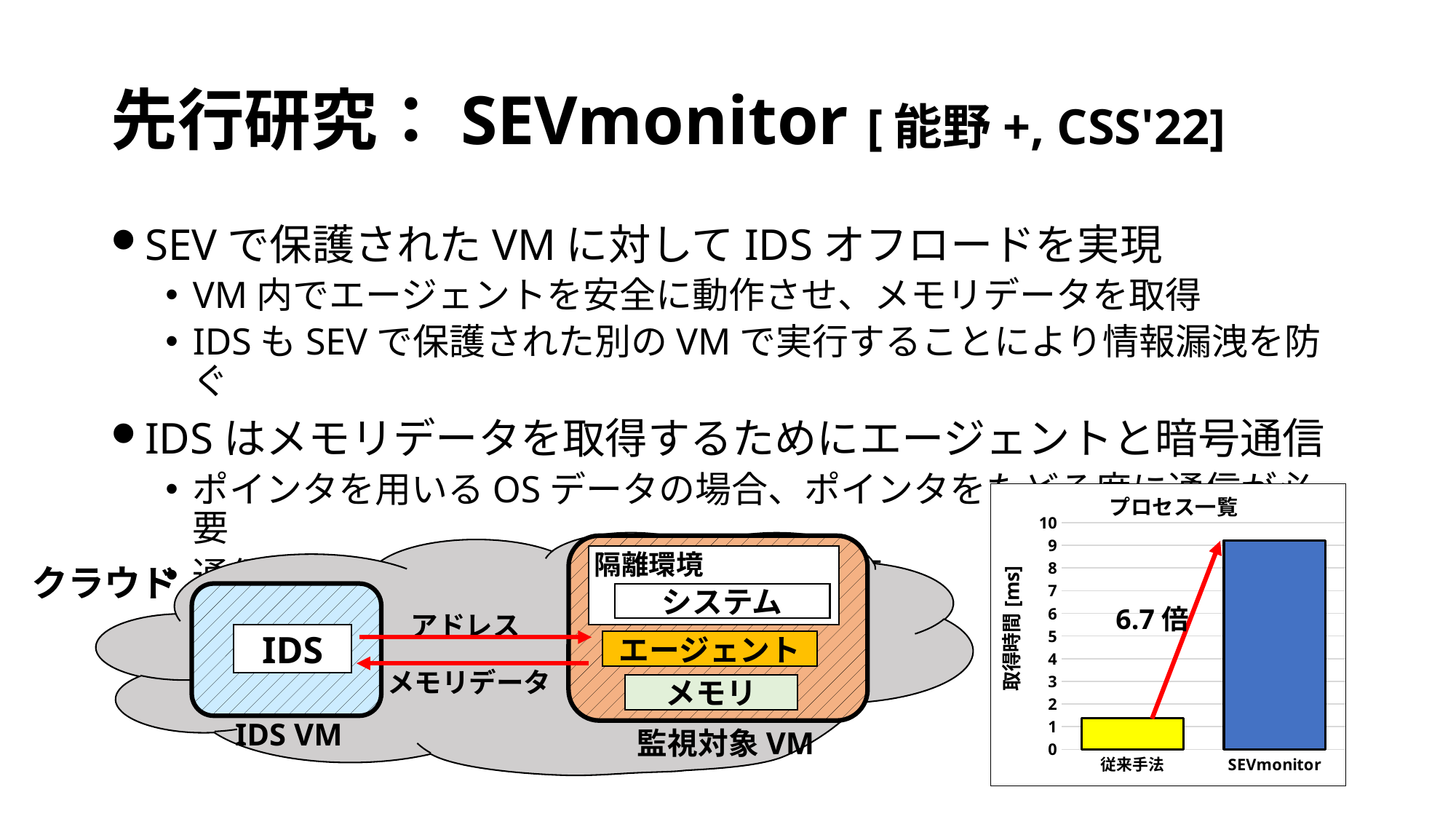
What is the title of the chart? プロセス一覧 Which category has the lowest 取得時間 in the chart? 従来手法 What ratio is annotated next to the red arrow between the two bars? 6.7 倍 Which category has the highest 取得時間 in the chart? SEVmonitor Do the values rise or fall going from 従来手法 to SEVmonitor along the x axis? rise Is the value for 従来手法 greater or less than 2? less What is the maximum value shown on the y axis of the chart? 10 What kind of chart is shown on the slide? bar chart How many bars (categories) does the chart show? 2 Which is larger, the value for 従来手法 or the value for SEVmonitor? SEVmonitor Is the value for SEVmonitor greater or less than 8? greater What is the label of the y axis of the chart? 取得時間 [ms]